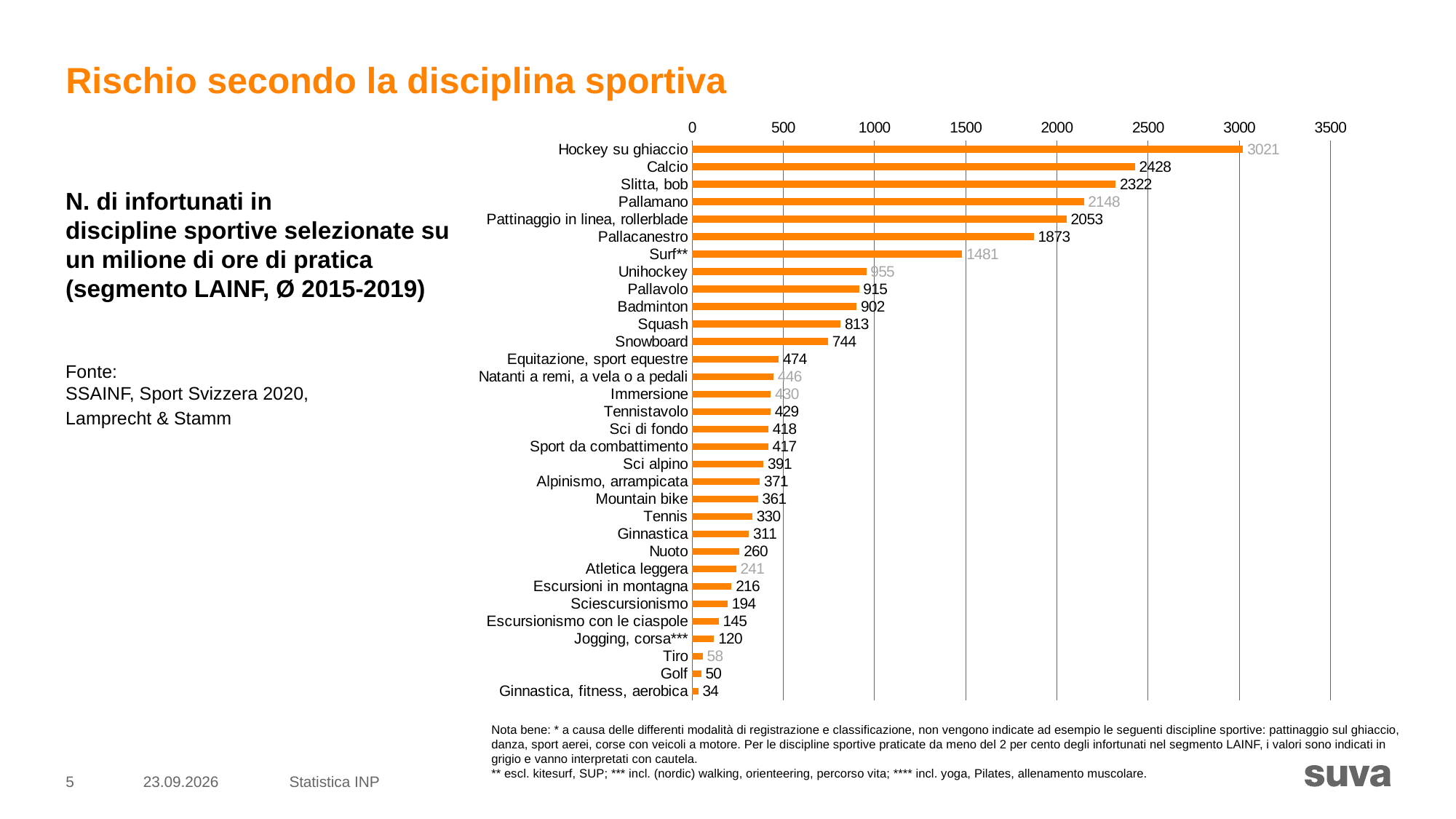
What is the value for Hockey su ghiaccio? 3021 What is the value for Golf? 50 What kind of chart is shown on the slide? bar chart Which category has the lowest value? Ginnastica, fitness, aerobica What is the title of the slide? Rischio secondo la disciplina sportiva How many categories are shown in the chart? 32 What is the value for Snowboard? 744 What is the difference between the values for Tennis and Nuoto? 70 Which is larger, the value for Pallavolo or the value for Badminton? Pallavolo What is the difference between the values for Calcio and Slitta, bob? 106 Is the value for Pallacanestro greater or less than 2000? less Which category has the highest value? Hockey su ghiaccio